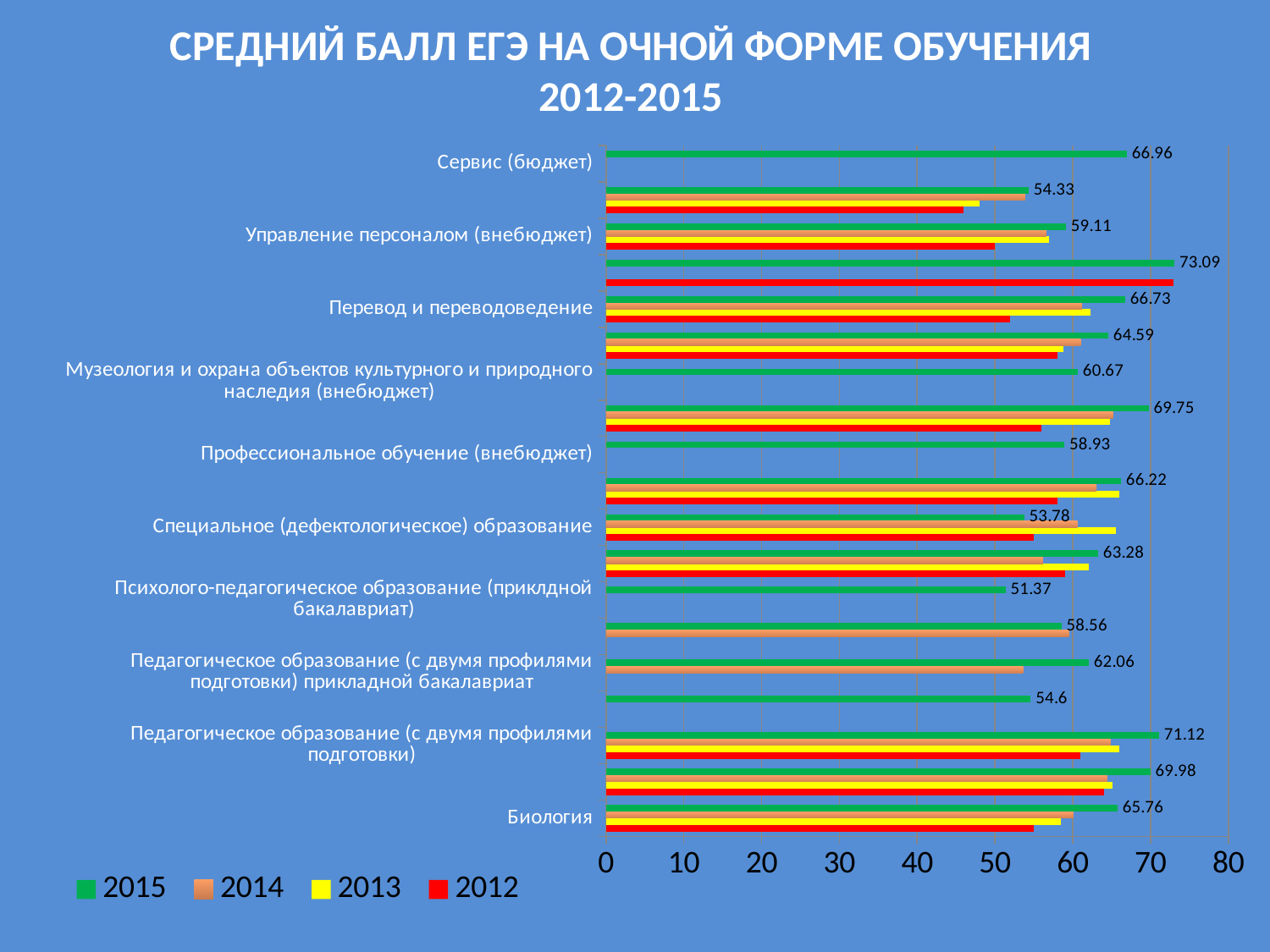
Which colour represents 2012 in the legend? red Is the 2012 value for Биология greater or less than 60? less What kind of chart is shown on the slide? bar chart How many series does the legend list? 4 Which labeled category has the lowest 2015 value? Психолого-педагогическое образование (прикладной бакалавриат) What is the 2015 value for Педагогическое образование (с двумя профилями подготовки)? 71.12 What is the 2015 value for Перевод и переводоведение? 66.73 Which has the larger 2015 value: Перевод и переводоведение or Музеология и охрана объектов культурного и природного наследия (внебюджет)? Перевод и переводоведение What is the 2015 value for Биология? 65.76 What is the difference between the 2015 values for Сервис (бюджет) and Биология? 1.2 What is the 2015 value for Психолого-педагогическое образование (прикладной бакалавриат)? 51.37 What is the 2015 value for Сервис (бюджет)? 66.96